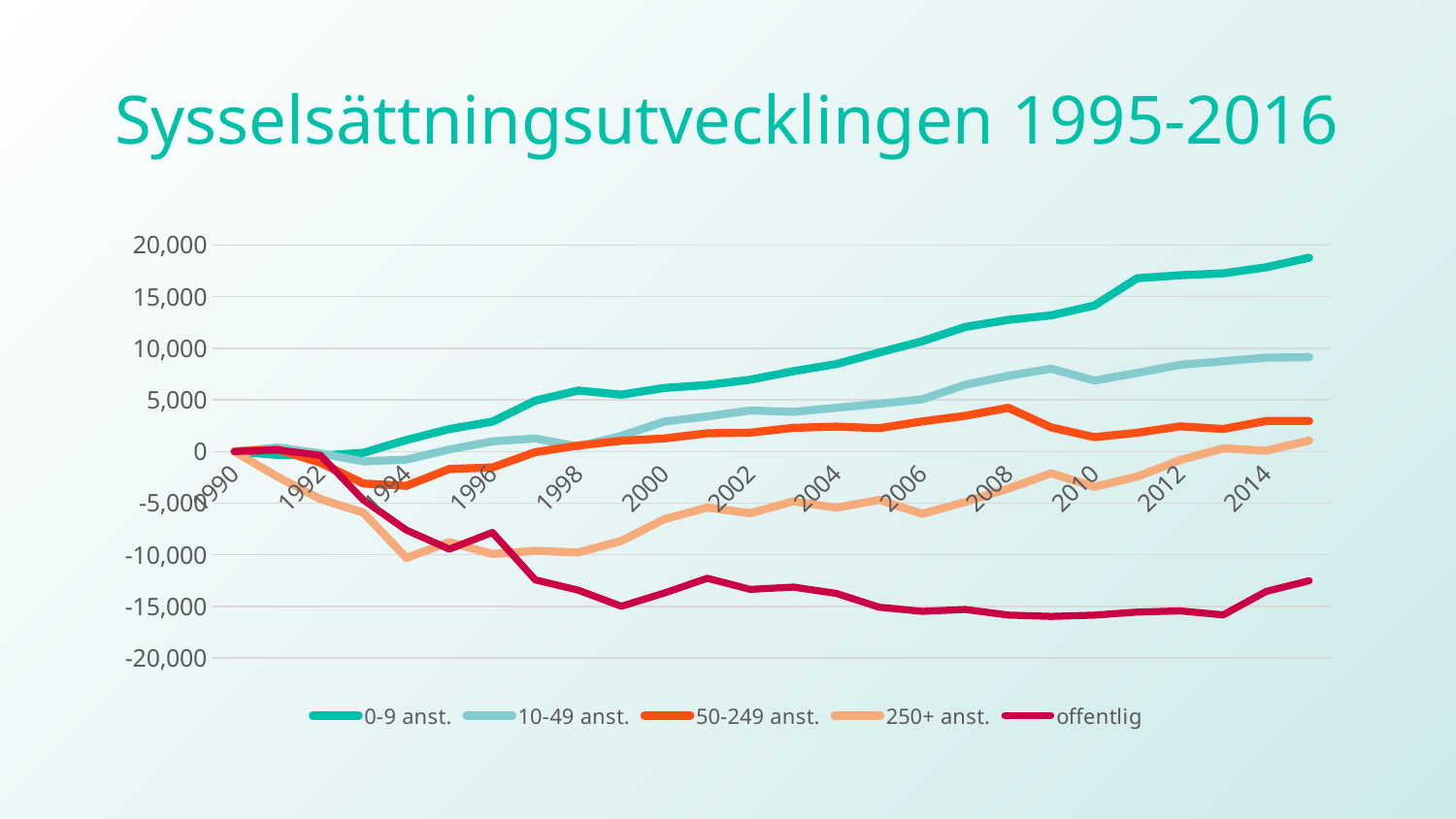
What kind of chart is shown on the slide? line chart What is the title of the chart? Sysselsättningsutvecklingen 1995-2016 Does the 0-9 anst. series generally rise or fall from 1990 to the end of the chart? rise In 2014, which series is larger: 0-9 anst. or 10-49 anst.? 0-9 anst. Which series has the lowest value at the right end of the chart (2014 onward)? offentlig Which series has the highest value at the right end of the chart (2014 onward)? 0-9 anst. Is the value for 10-49 anst. in 2014 greater or less than 5,000? greater Does the offentlig series generally rise or fall from 1990 to 2010? fall Is the value for offentlig in 2004 greater or less than -10,000? less How many series does the legend list? 5 Is the value for 0-9 anst. in 2014 greater or less than 15,000? greater